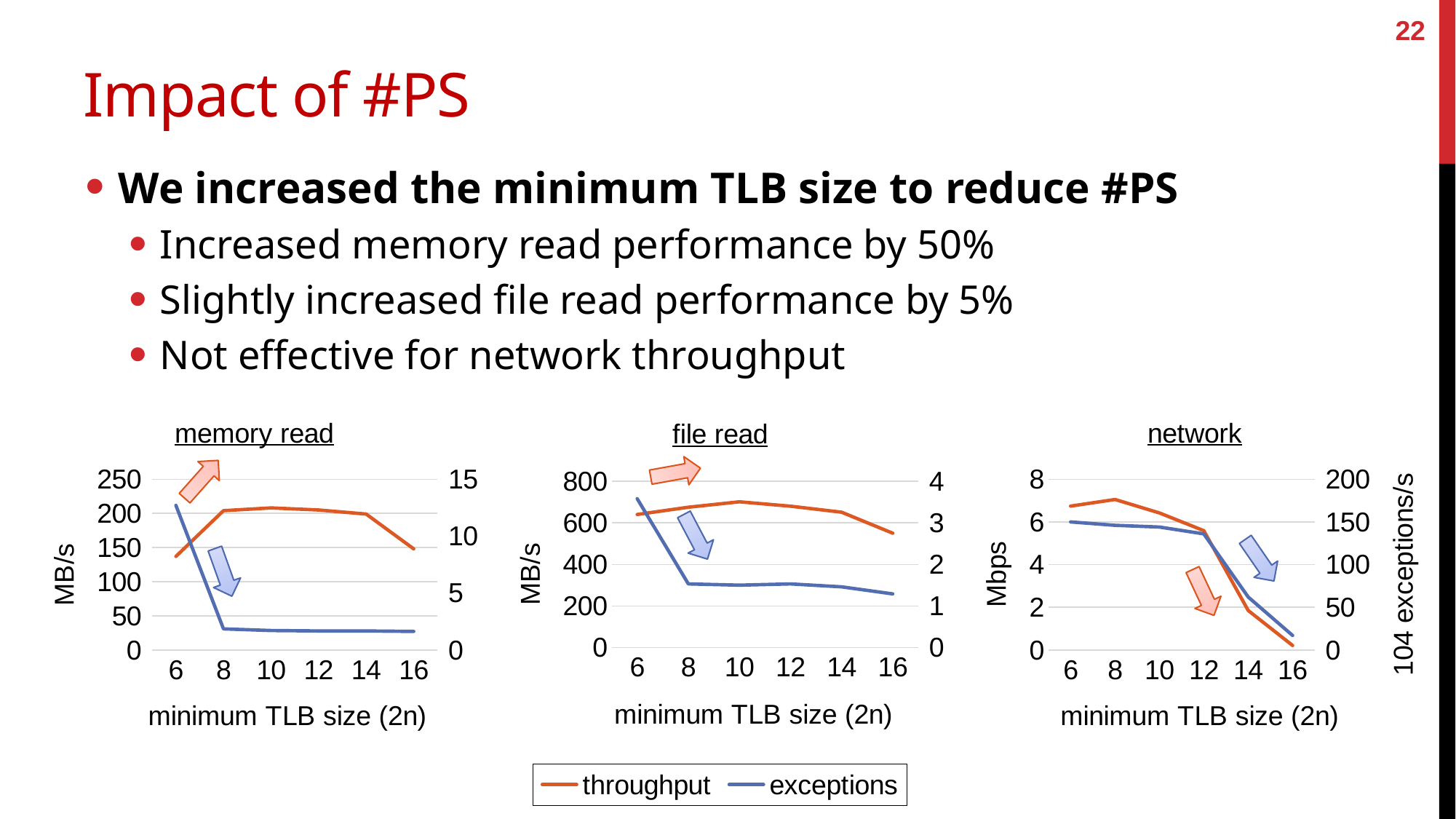
In the file read chart, at which minimum TLB size is throughput lowest? 16 What kind of chart is the memory read chart? line chart In the network chart, does throughput rise or fall from minimum TLB size 12 to 16? fall In the network chart, is the exceptions value at minimum TLB size 6 greater or less than 100? greater In the network chart, is the throughput at minimum TLB size 16 greater or less than 2? less In the memory read chart, is the exceptions value at minimum TLB size 6 greater or less than 10? greater How many series does the legend list for the charts? 2 In the memory read chart, how many minimum TLB size values are plotted along the x axis? 6 In the memory read chart, which is larger: the exceptions value at minimum TLB size 6 or at 8? 6 What is the left vertical axis label of the network chart? Mbps